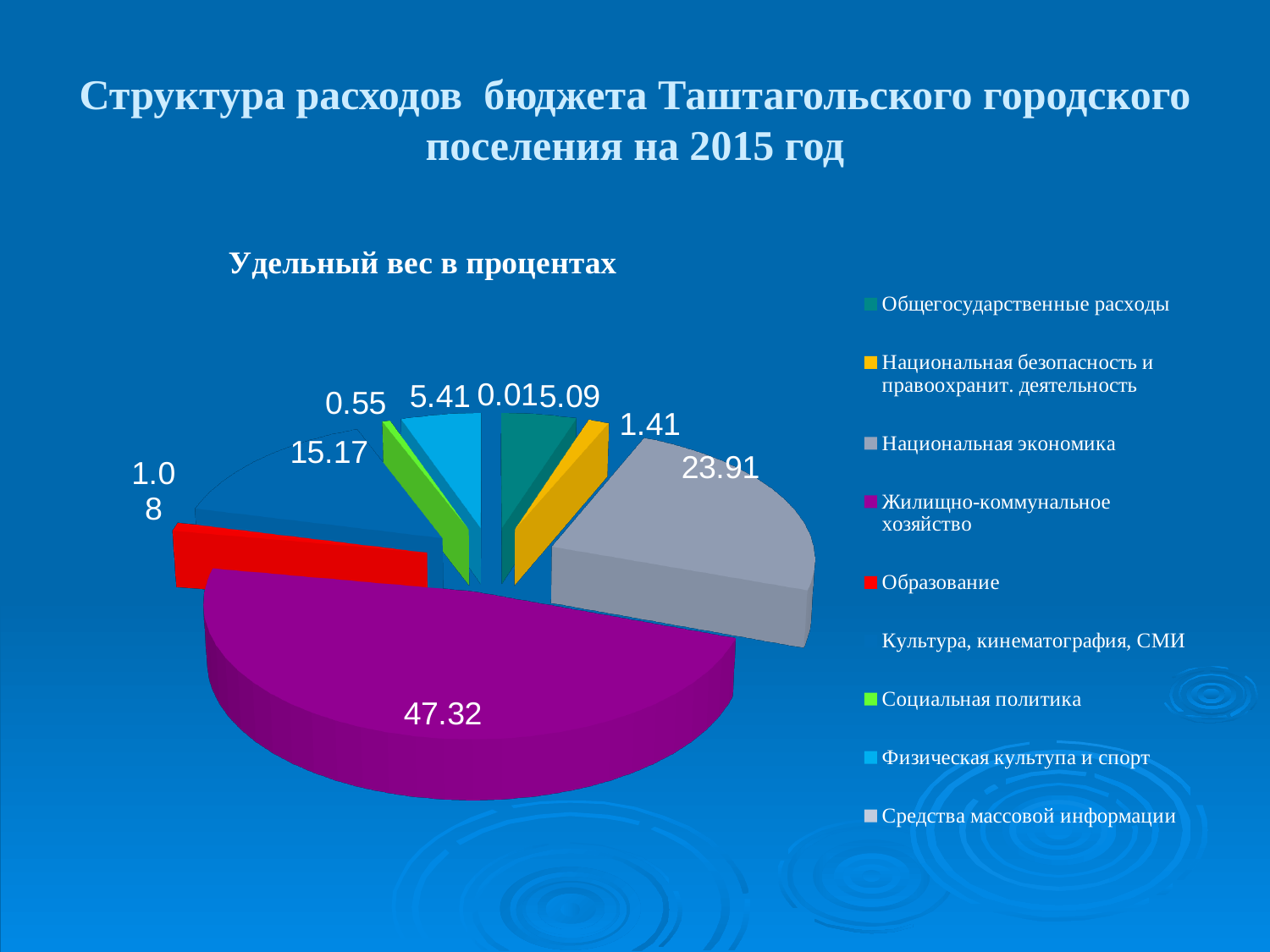
What is the value shown for Национальная безопасность и правоохранит. деятельность? 1.41 What is the value shown for Общегосударственные расходы? 5.09 What is the value shown for Национальная экономика? 23.91 What is the title of the chart? Удельный вес в процентах What is the value shown for Жилищно-коммунальное хозяйство? 47.32 What colour is the slice for Жилищно-коммунальное хозяйство? purple Which category has the largest share of the pie? Жилищно-коммунальное хозяйство What is the smallest value labelled on the pie chart? 0.01 What is the difference between the values for Жилищно-коммунальное хозяйство and Национальная экономика? 23.41 Which is larger, the value for Национальная экономика or the value for Общегосударственные расходы? Национальная экономика How many categories does the legend of the pie chart list? 9 What kind of chart is shown on the slide? pie chart